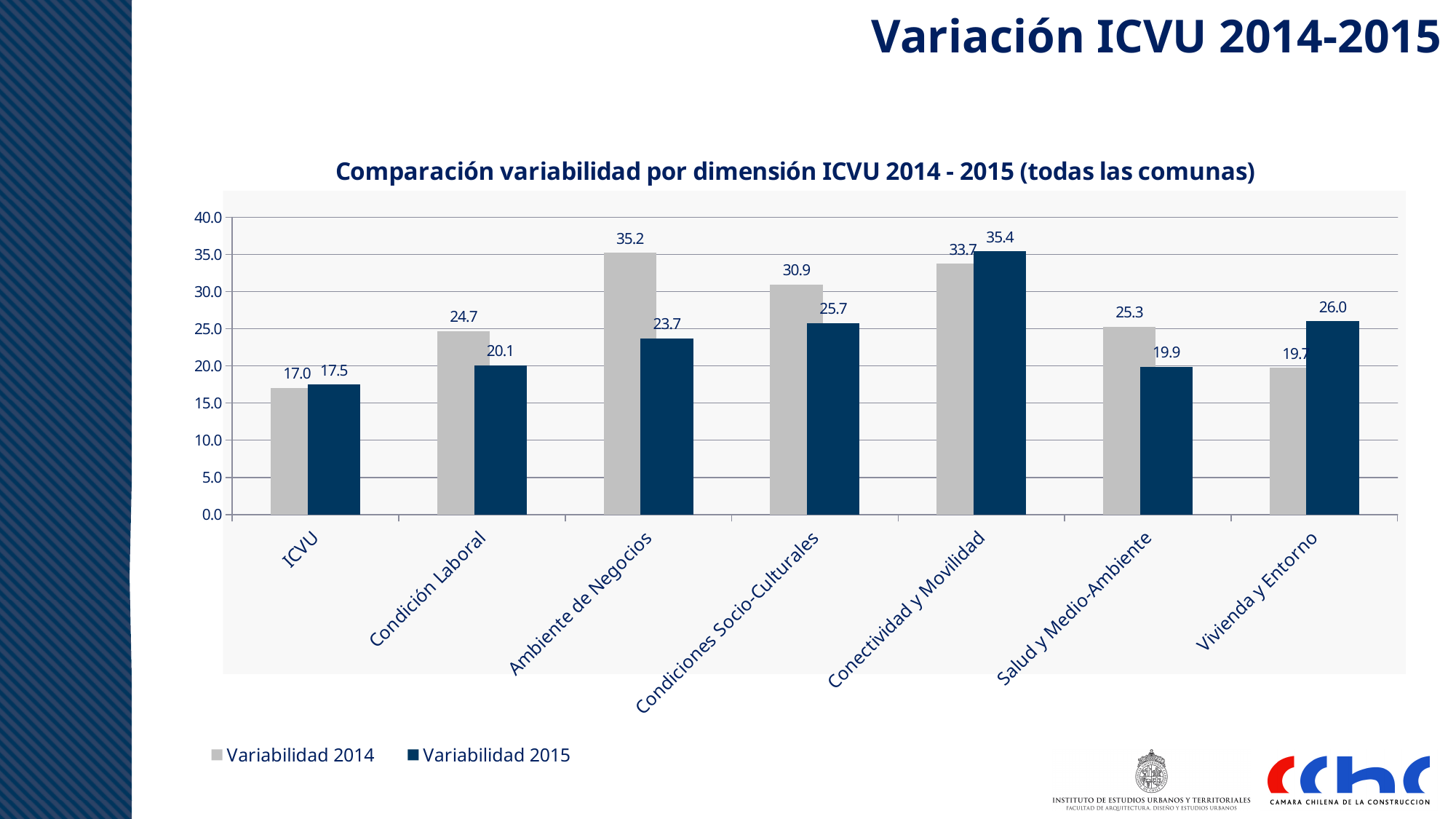
What is the Variabilidad 2014 value for Ambiente de Negocios? 35.2 Which category has the highest Variabilidad 2015 value? Conectividad y Movilidad Is the Variabilidad 2014 value for Condiciones Socio-Culturales greater or less than 30.0? greater Which category has the lowest Variabilidad 2014 value? ICVU What is the Variabilidad 2015 value for Condición Laboral? 20.1 What is the title of the chart? Comparación variabilidad por dimensión ICVU 2014 - 2015 (todas las comunas) What kind of chart is shown on the slide? Bar chart For Salud y Medio-Ambiente, which is larger: Variabilidad 2014 or Variabilidad 2015? Variabilidad 2014 How many categories are shown on the x axis? 7 What is the difference between the Variabilidad 2014 and Variabilidad 2015 values for Ambiente de Negocios? 11.5 What is the Variabilidad 2015 value for Vivienda y Entorno? 26.0 How many series does the legend list? 2